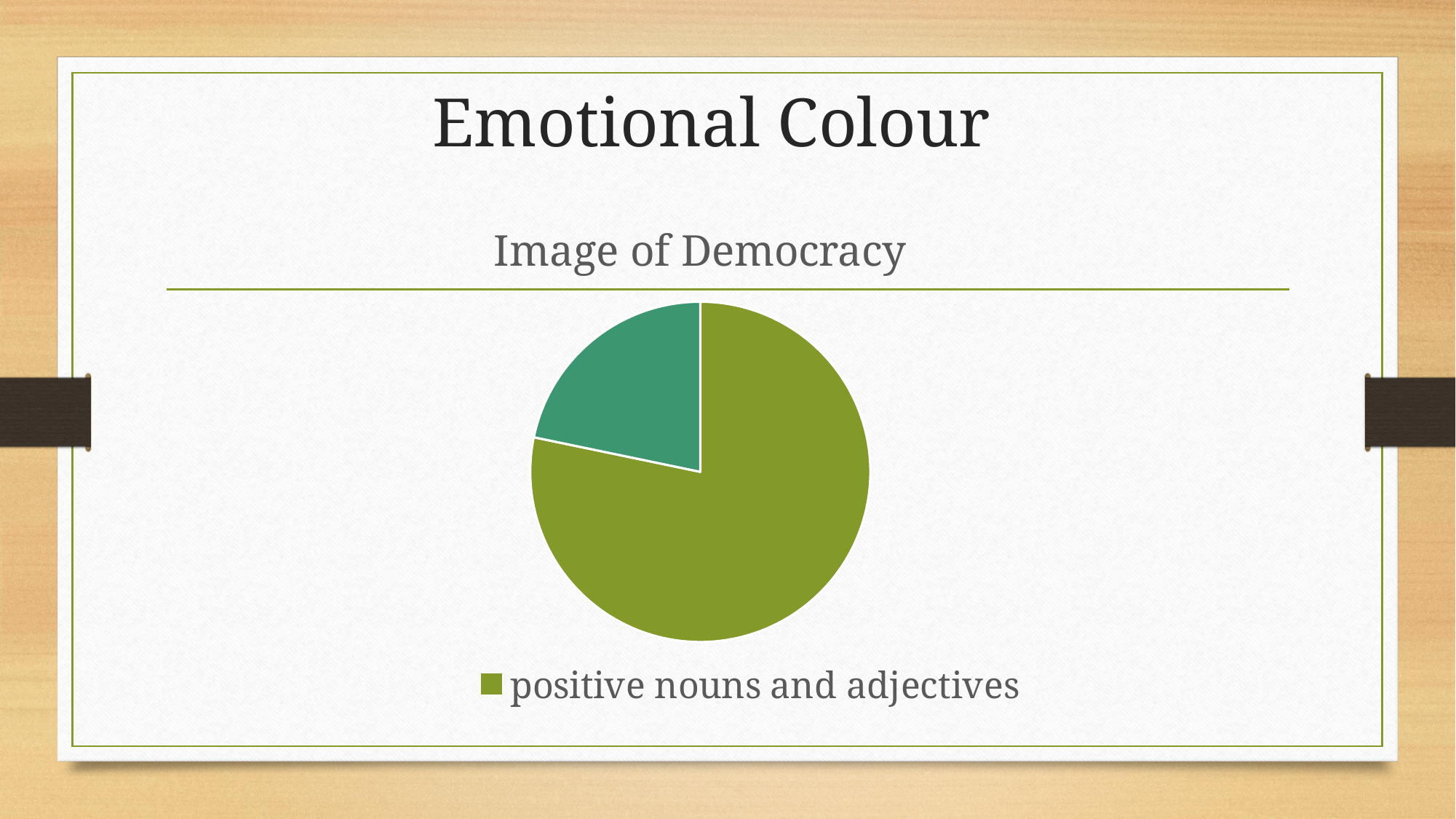
How many entries does the chart's legend list? 1 How many slices does the pie chart have? 2 Which category is named in the chart's legend? positive nouns and adjectives Which slice is larger, the olive green slice or the teal slice? the olive green slice What kind of chart is shown on the slide? pie chart Which slice of the pie is the largest? positive nouns and adjectives What is the title of the chart? Image of Democracy Does the slice for positive nouns and adjectives cover more or less than half of the pie? more